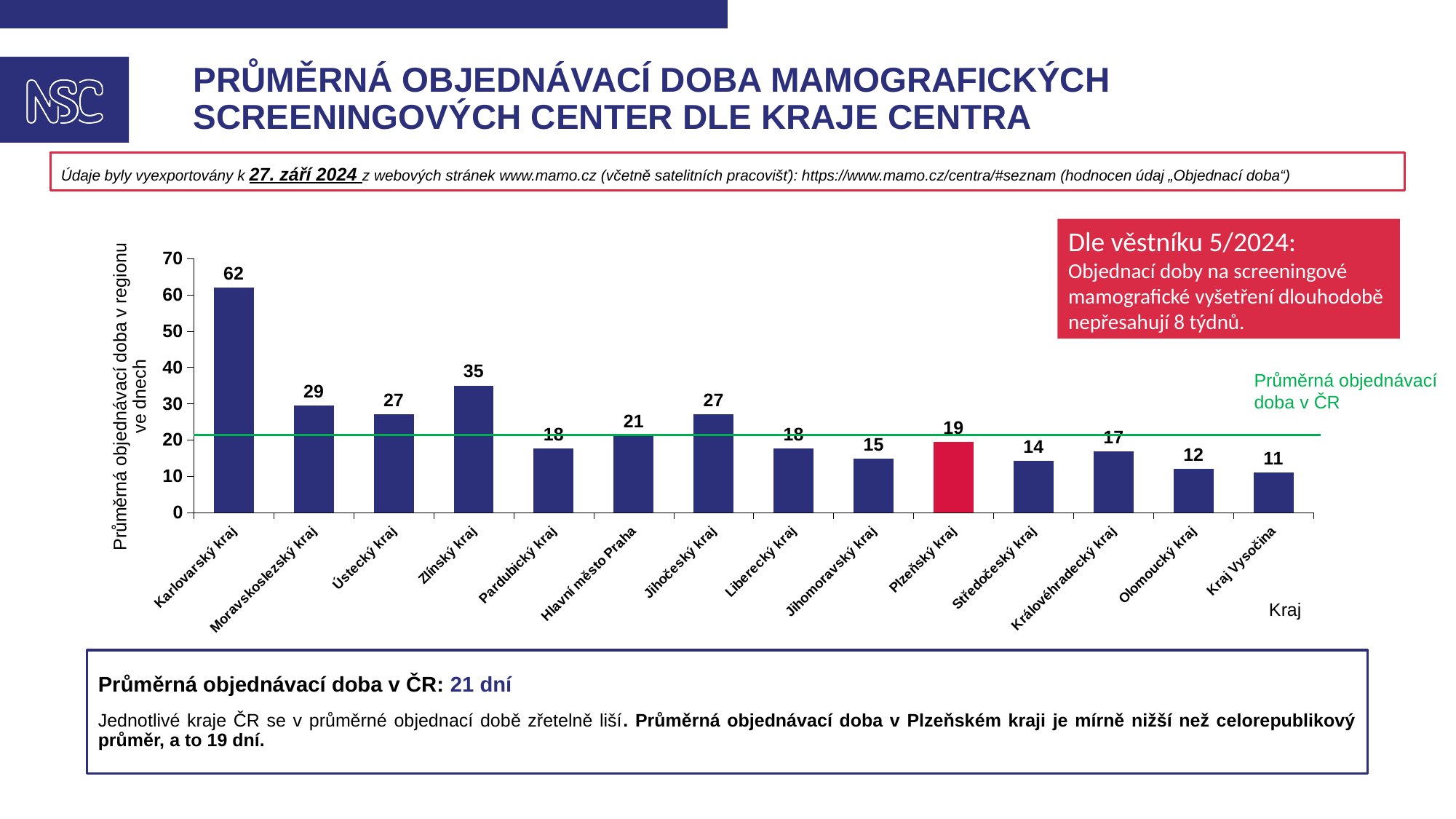
What does the green horizontal line across the chart represent? Průměrná objednávací doba v ČR Is the value for Zlínský kraj greater or less than 30? greater How many regions are shown on the x axis of the chart? 14 Which region has the lowest average ordering time? Kraj Vysočina What kind of chart is shown on the slide? bar chart What is the value shown for Plzeňský kraj? 19 What is the value shown for Hlavní město Praha? 21 What is the difference between the values for Karlovarský kraj and Zlínský kraj? 27 Which region has the highest average ordering time? Karlovarský kraj What is the average ordering time for Karlovarský kraj? 62 Which has a larger value, Moravskoslezský kraj or Jihočeský kraj? Moravskoslezský kraj Which region's bar is highlighted in red? Plzeňský kraj